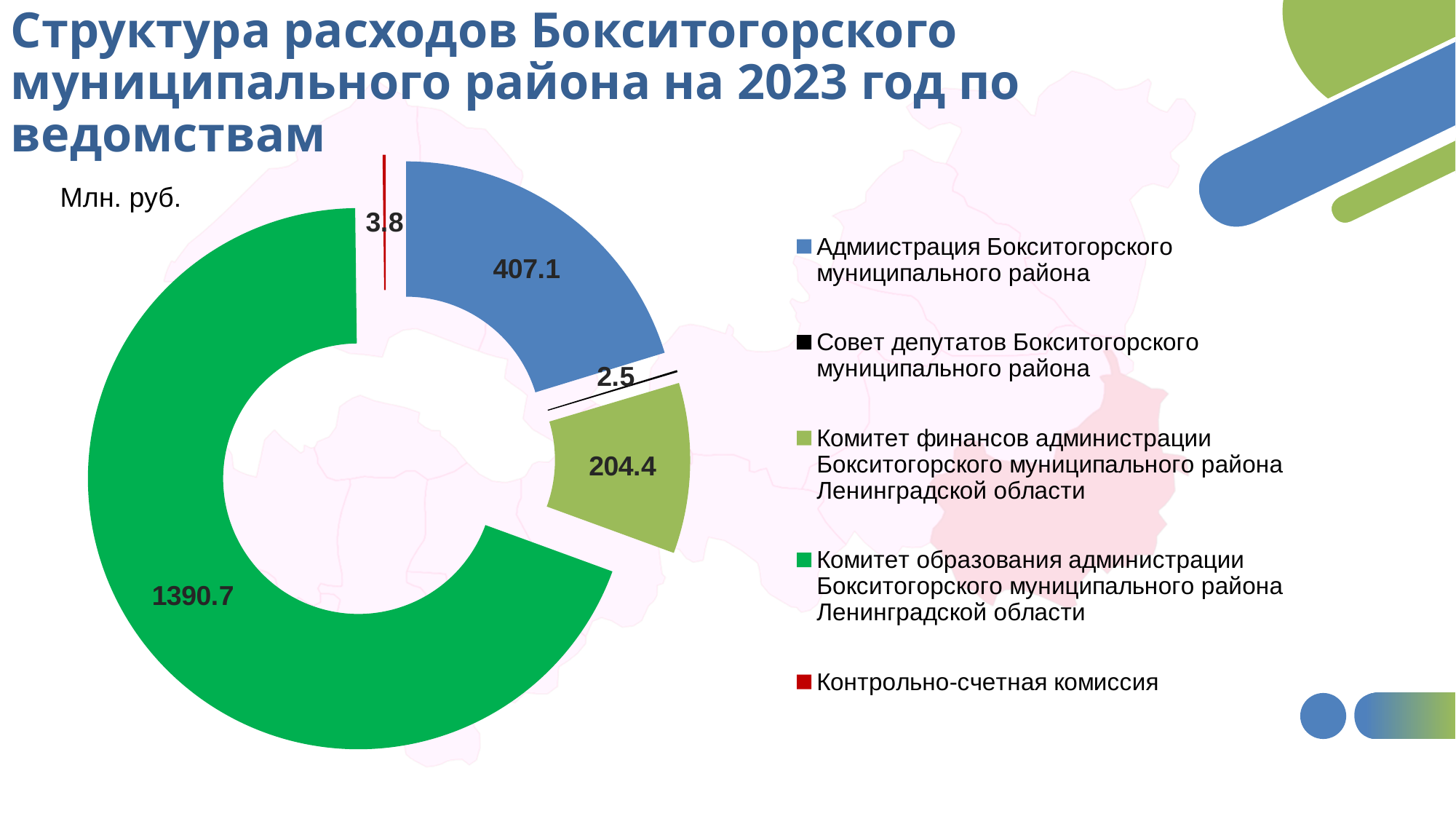
What kind of chart is shown on the slide? Doughnut (pie) chart What unit is indicated for the values on the chart? Млн. руб. What is the value for Совет депутатов Бокситогорского муниципального района? 2.5 What is the value for Комитет образования администрации Бокситогорского муниципального района Ленинградской области? 1390.7 What is the difference between the values for Комитет образования and Админстрация Бокситогорского муниципального района? 983.6 What is the value for Контрольно-счетная комиссия? 3.8 Which category has the largest value? Комитет образования администрации Бокситогорского муниципального района Ленинградской области How many categories does the legend list? 5 What is the value for Админстрация Бокситогорского муниципального района? 407.1 Which is larger: the value for Админстрация Бокситогорского муниципального района or for Комитет финансов? Админстрация Бокситогорского муниципального района What is the value for Комитет финансов администрации Бокситогорского муниципального района Ленинградской области? 204.4 Which category has the smallest value? Совет депутатов Бокситогорского муниципального района